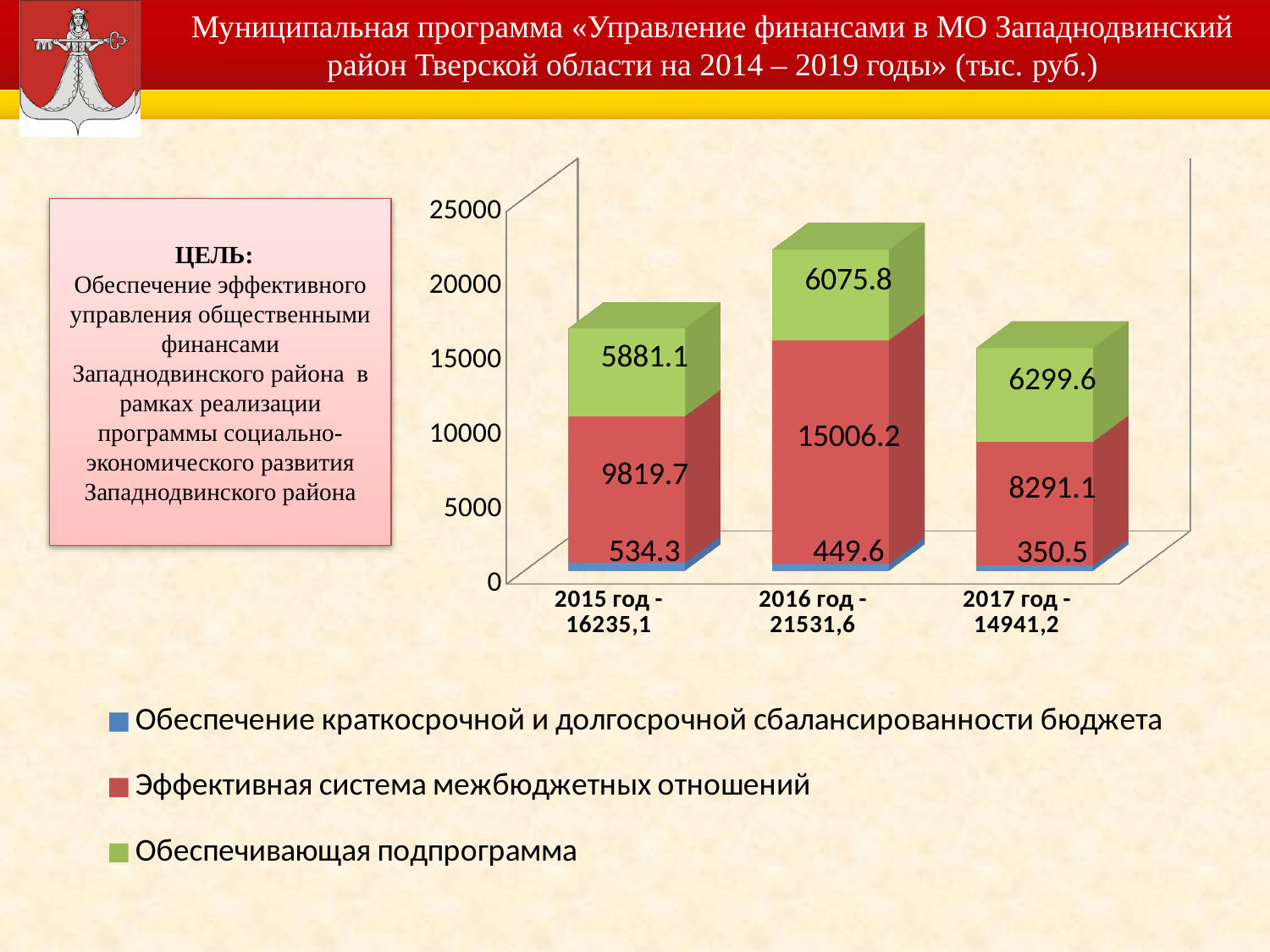
What kind of chart is shown on the slide? Stacked bar chart What is the difference between the 'Обеспечивающая подпрограмма' values for 2017 and 2015? 418.5 Which colour represents the 'Обеспечивающая подпрограмма' series? Green Which is larger: the 'Эффективная система межбюджетных отношений' value for 2015 or for 2017? 2015 How many series does the legend list? 3 In which year is the 'Эффективная система межбюджетных отношений' value highest? 2016 What is the value of the 'Обеспечение краткосрочной и долгосрочной сбалансированности бюджета' series for 2015? 534.3 In which year is the 'Обеспечение краткосрочной и долгосрочной сбалансированности бюджета' value lowest? 2017 What is the value of the 'Эффективная система межбюджетных отношений' series for 2016? 15006.2 How many years (categories) are shown on the chart? 3 What is the total of the stacked bar for 2016? 21531,6 What is the value of the 'Обеспечивающая подпрограмма' series for 2017? 6299.6